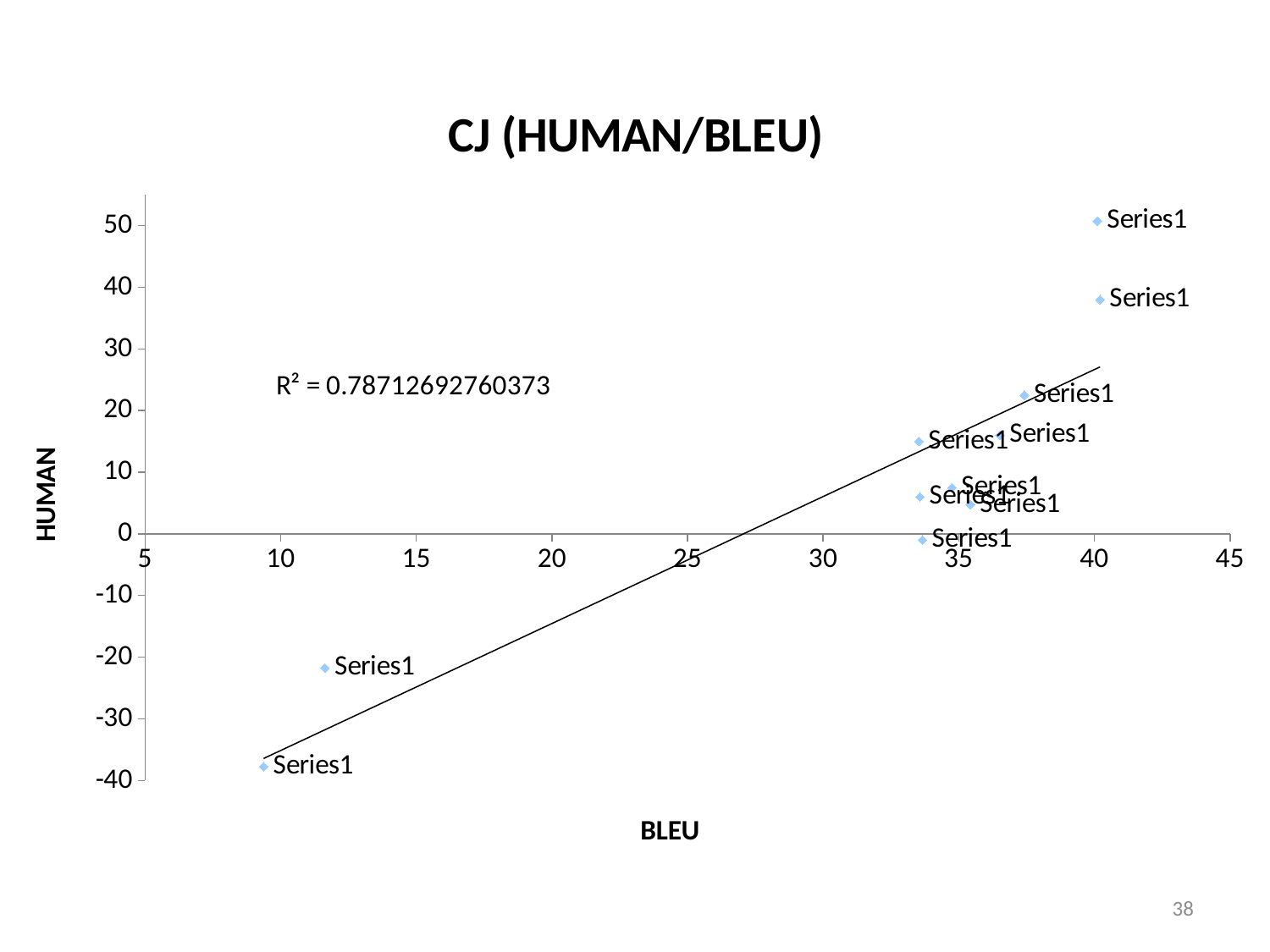
How many plotted points have a BLEU value below 20? 2 Is the BLEU value of the point with the lowest HUMAN score greater or less than 15? less What are the labels of the x axis and the y axis of the chart? BLEU (x axis) and HUMAN (y axis) How many plotted points have a HUMAN value above 30? 2 What is the highest value shown on the BLEU axis? 45 What kind of chart is shown on the slide? Scatter chart What is the title of the chart? CJ (HUMAN/BLEU) Is the lowest HUMAN value plotted on the chart greater or less than -30? less Is the highest HUMAN value plotted on the chart greater or less than 40? greater What R² value is printed on the chart? R² = 0.78712692760373 As BLEU increases along the x axis, do the HUMAN values generally rise or fall? Rise